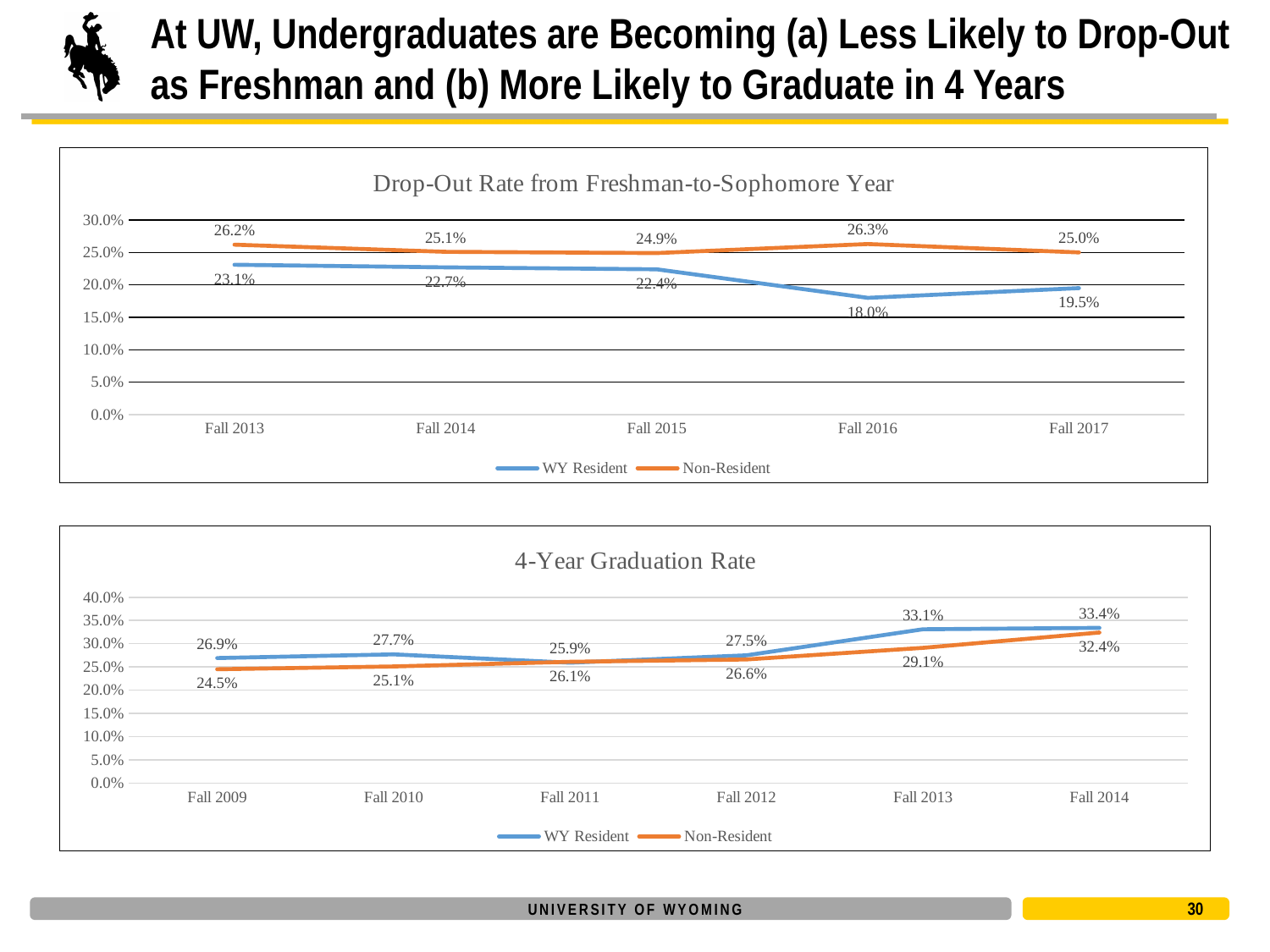
In the 'Drop-Out Rate from Freshman-to-Sophomore Year' chart, in which year is the WY Resident drop-out rate lowest? Fall 2016 In the 'Drop-Out Rate from Freshman-to-Sophomore Year' chart, how many years are shown on the x axis? 5 In the '4-Year Graduation Rate' chart, which is larger for Fall 2013: WY Resident or Non-Resident? WY Resident In the '4-Year Graduation Rate' chart, does the Non-Resident graduation rate rise or fall from Fall 2009 to Fall 2014? Rise In the '4-Year Graduation Rate' chart, what is the Non-Resident value for Fall 2014? 32.4% In the '4-Year Graduation Rate' chart, what is the WY Resident value for Fall 2013? 33.1% In the '4-Year Graduation Rate' chart, in which year is the Non-Resident graduation rate highest? Fall 2014 In the 'Drop-Out Rate from Freshman-to-Sophomore Year' chart, what is the Non-Resident value for Fall 2013? 26.2% In the 'Drop-Out Rate from Freshman-to-Sophomore Year' chart, what is the WY Resident value for Fall 2016? 18.0% In the 'Drop-Out Rate from Freshman-to-Sophomore Year' chart, what is the difference between the Non-Resident and WY Resident values for Fall 2016? 8.3% In the 'Drop-Out Rate from Freshman-to-Sophomore Year' chart, how many series does the legend list? 2 What type of chart is the '4-Year Graduation Rate' chart? Line chart